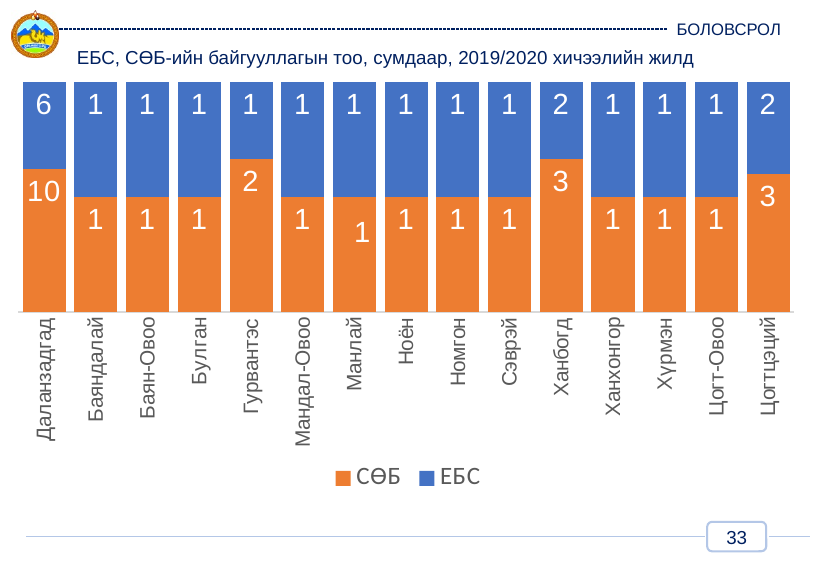
What is the difference between the СӨБ and ЕБС values for Даланзадгад? 4 What is the СӨБ value for Гурвантэс? 2 Which is larger, the СӨБ value for Гурвантэс or the СӨБ value for Ханбогд? Ханбогд What is the total of the stacked bar for Даланзадгад? 16 What is the ЕБС value for Цогтцэций? 2 How many series does the legend list? 2 How many categories are shown on the x axis? 15 What is the ЕБС value for Даланзадгад? 6 What is the total of the stacked bar for Ханбогд? 5 What is the СӨБ value for Даланзадгад? 10 What is the СӨБ value for Ханбогд? 3 Which category has the highest СӨБ value? Даланзадгад